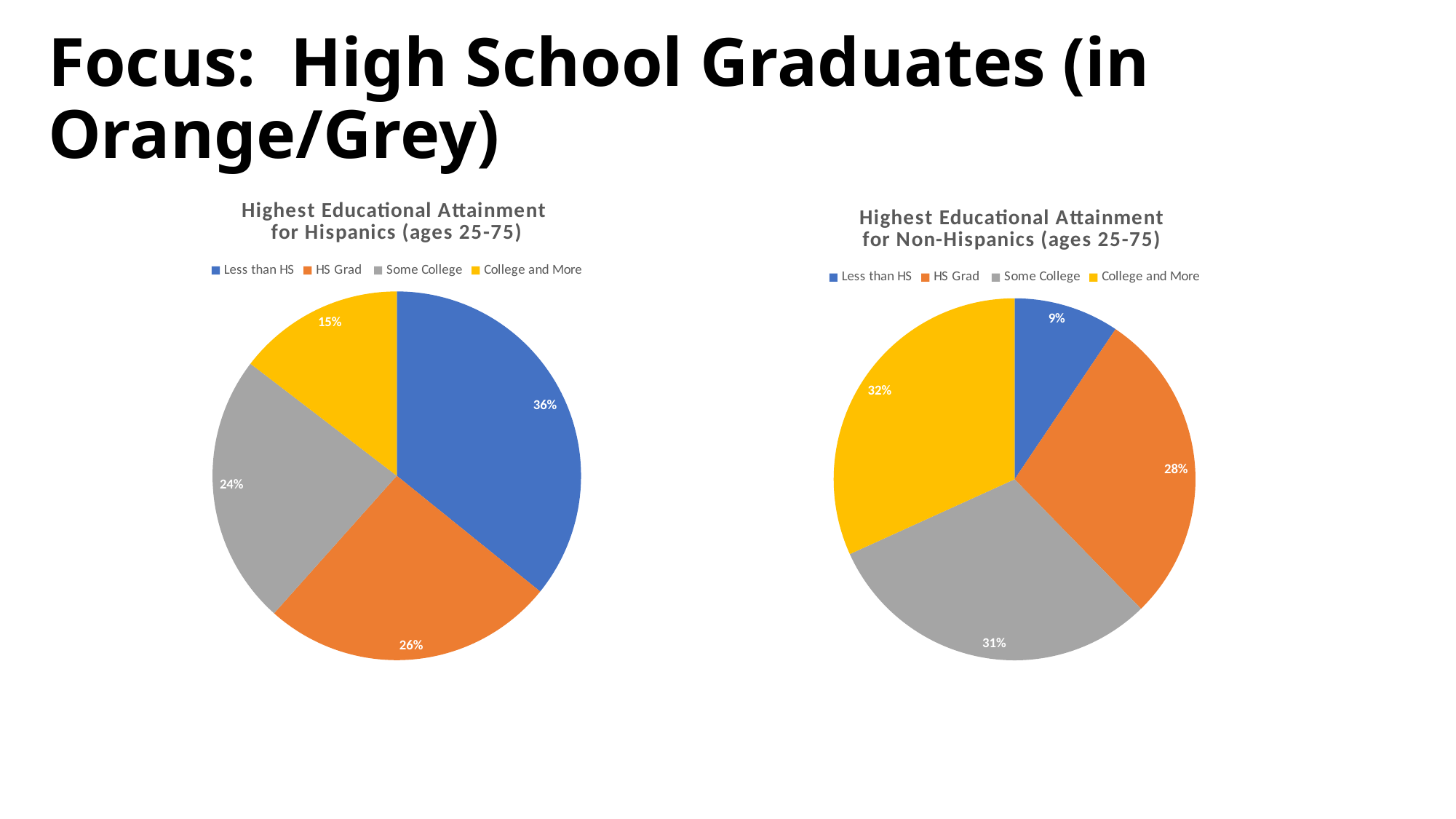
What is the difference in percentage points between the Less than HS share in the Hispanics chart and the Less than HS share in the Non-Hispanics chart? 27 In the 'Highest Educational Attainment for Non-Hispanics (ages 25-75)' chart, which category has the largest slice? College and More In the 'Highest Educational Attainment for Non-Hispanics (ages 25-75)' chart, what share is labelled for Less than HS? 9% How many slices does the 'Highest Educational Attainment for Non-Hispanics (ages 25-75)' pie chart have? 4 In the 'Highest Educational Attainment for Hispanics (ages 25-75)' chart, which category has the smallest slice? College and More In the 'Highest Educational Attainment for Hispanics (ages 25-75)' chart, which is larger: Some College or College and More? Some College What type of chart is used for 'Highest Educational Attainment for Non-Hispanics (ages 25-75)'? Pie chart In the 'Highest Educational Attainment for Hispanics (ages 25-75)' chart, which category has the largest slice? Less than HS In the 'Highest Educational Attainment for Hispanics (ages 25-75)' chart, what share is labelled for HS Grad? 26% In the 'Highest Educational Attainment for Hispanics (ages 25-75)' chart, what colour is the Some College slice? Grey How many entries does the legend of the 'Highest Educational Attainment for Hispanics (ages 25-75)' chart list? 4 In the 'Highest Educational Attainment for Non-Hispanics (ages 25-75)' chart, which category has the smallest slice? Less than HS